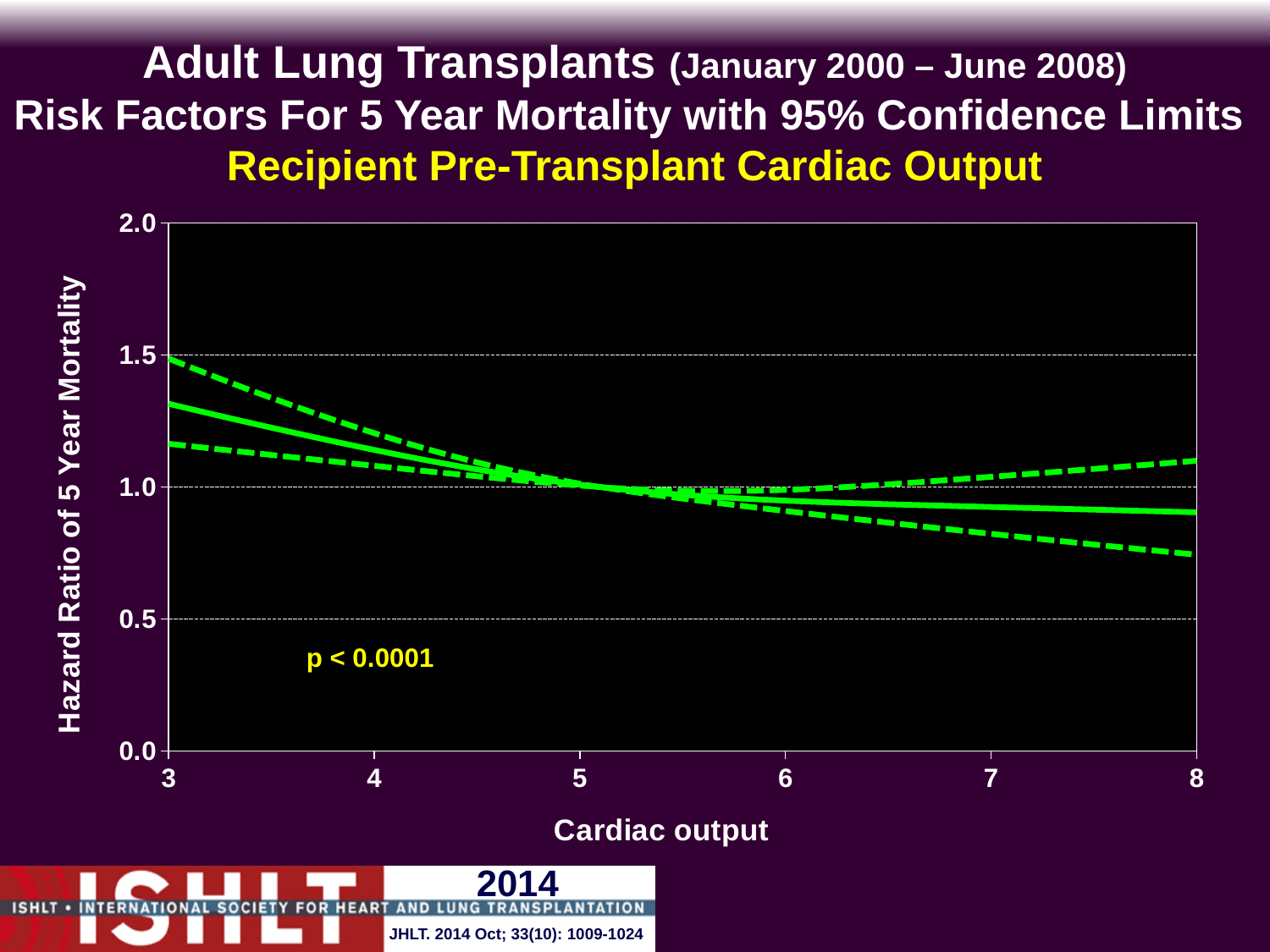
Is the solid hazard ratio line at a cardiac output of 3 greater or less than 1.5? less Is the hazard ratio on the solid line higher at a cardiac output of 3 or at a cardiac output of 8? 3 What kind of chart is shown on the slide? line chart Is the upper dashed confidence limit at a cardiac output of 8 greater or less than 1.0? greater Is the hazard ratio on the solid line at a cardiac output of 3 greater or less than 1.0? greater Does the solid hazard ratio line rise or fall as cardiac output increases from 3 to 8? fall How many lines are plotted on the chart? 3 What is the highest value shown on the y axis? 2.0 What p-value is printed on the chart? p < 0.0001